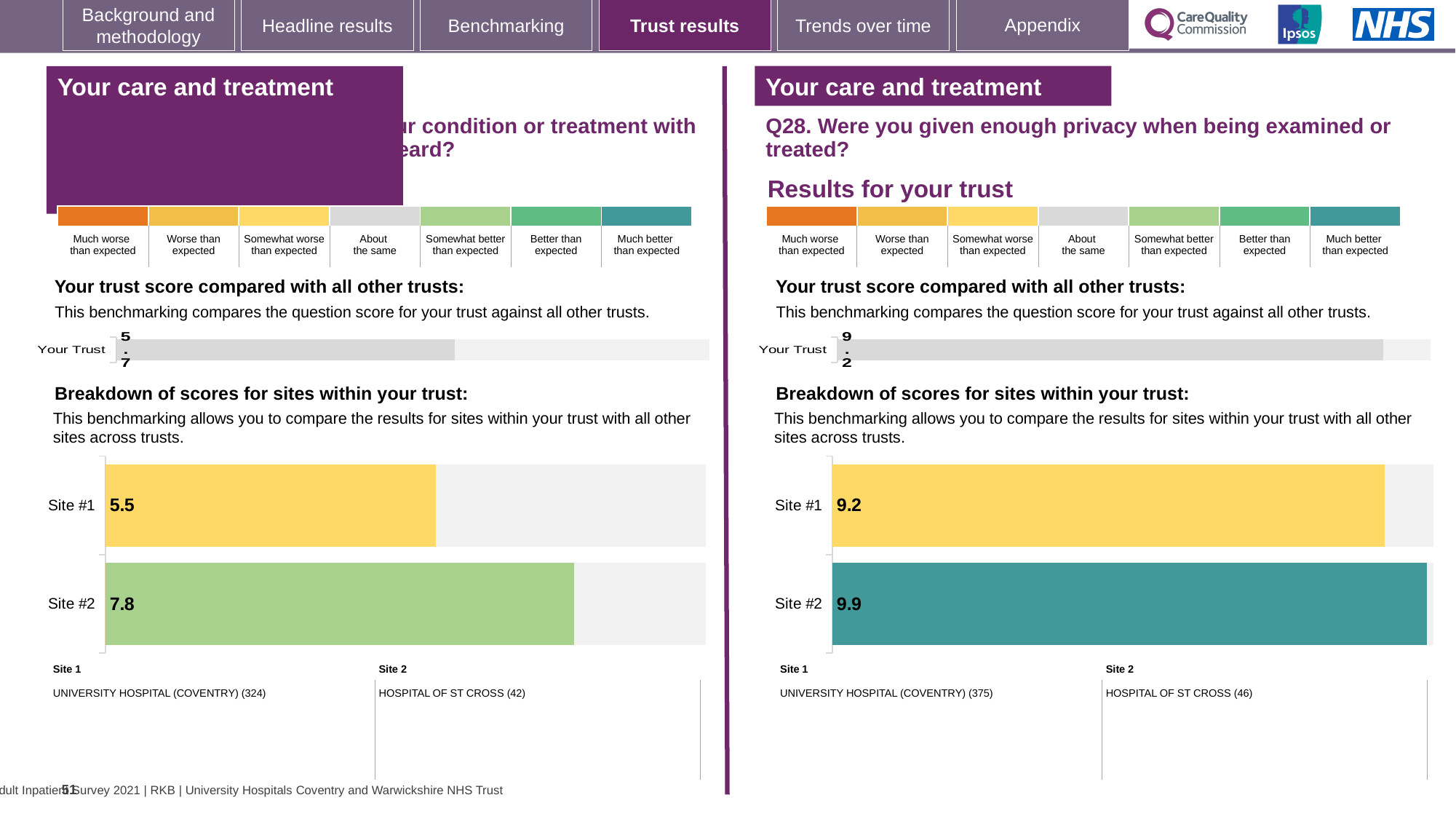
On the left-hand panel's site breakdown chart, what is the score for Site #2? 7.8 On the Q28 (privacy when being examined or treated) site breakdown chart, what is the score for Site #1? 9.2 On the left-hand panel's site breakdown chart, what is the score for Site #1? 5.5 On the Q28 site breakdown chart, which site has the lower score? Site #1 On the left-hand panel's site breakdown chart, what is the difference between the Site #2 and Site #1 scores? 2.3 On the Q28 site breakdown chart, what is the difference between the Site #2 and Site #1 scores? 0.7 On the Q28 (privacy when being examined or treated) site breakdown chart, what is the score for Site #2? 9.9 On the Q28 panel, what is the 'Your Trust' score shown in the trust comparison bar? 9.2 What type of chart is used for the breakdown of scores for sites on the Q28 panel? Bar chart How many sites are shown in the site breakdown chart on the Q28 panel? 2 On the left-hand panel's site breakdown chart, which site has the higher score? Site #2 On the left-hand panel, what is the 'Your Trust' score shown in the trust comparison bar? 5.7